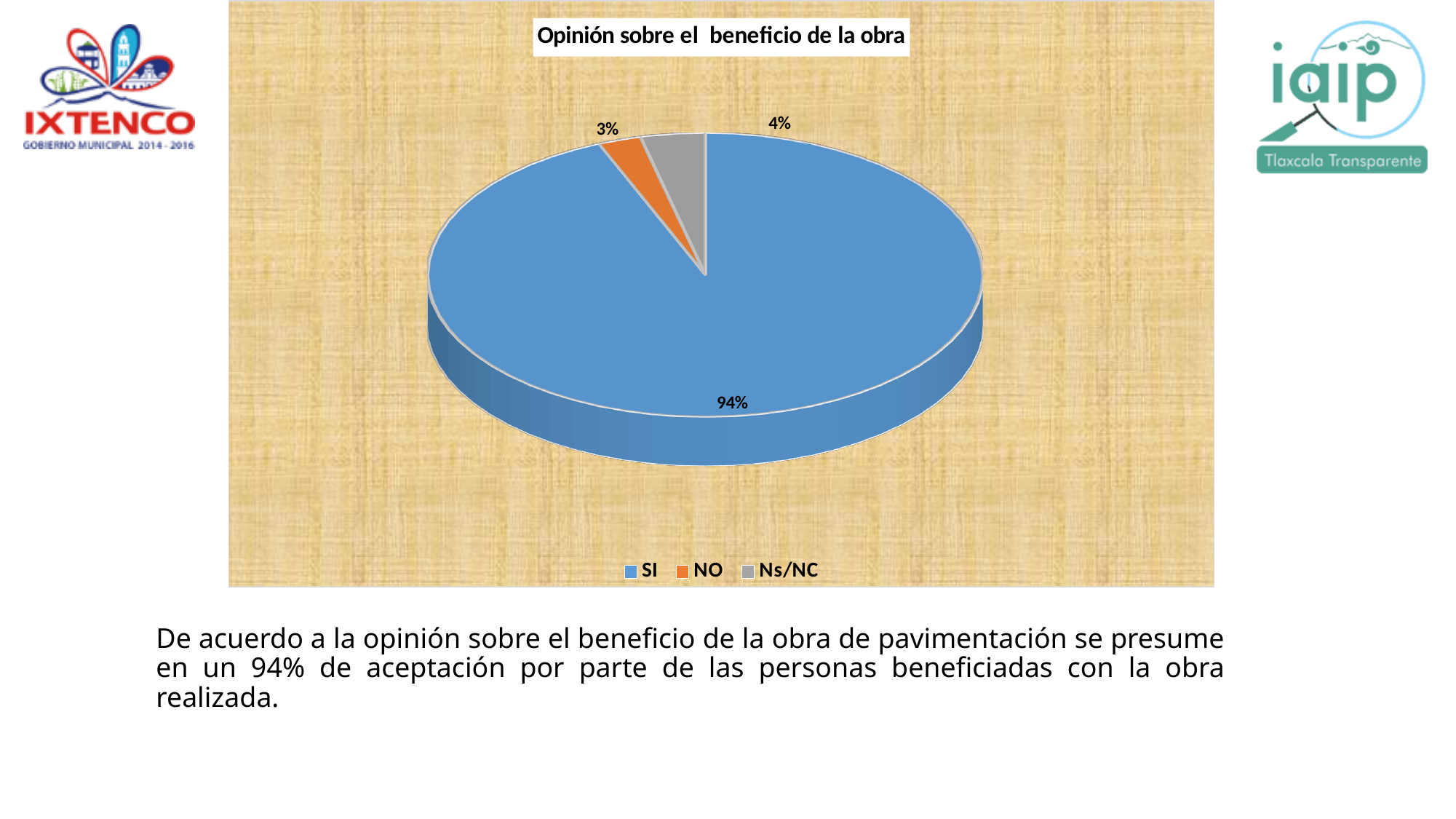
What is the title of the chart? Opinión sobre el beneficio de la obra Which category has the smallest slice of the pie? NO How many categories does the pie chart show? 3 Which category has the largest slice of the pie? SI What colour is the SI slice in the pie chart? Blue What is the value shown for NO? 3% What is the difference between the SI slice and the Ns/NC slice? 90% What is the difference between the Ns/NC slice and the NO slice? 1% What share of the pie does SI represent? 94% What is the value shown for Ns/NC? 4% What kind of chart is shown on the slide? Pie chart Which is larger, the NO slice or the Ns/NC slice? Ns/NC